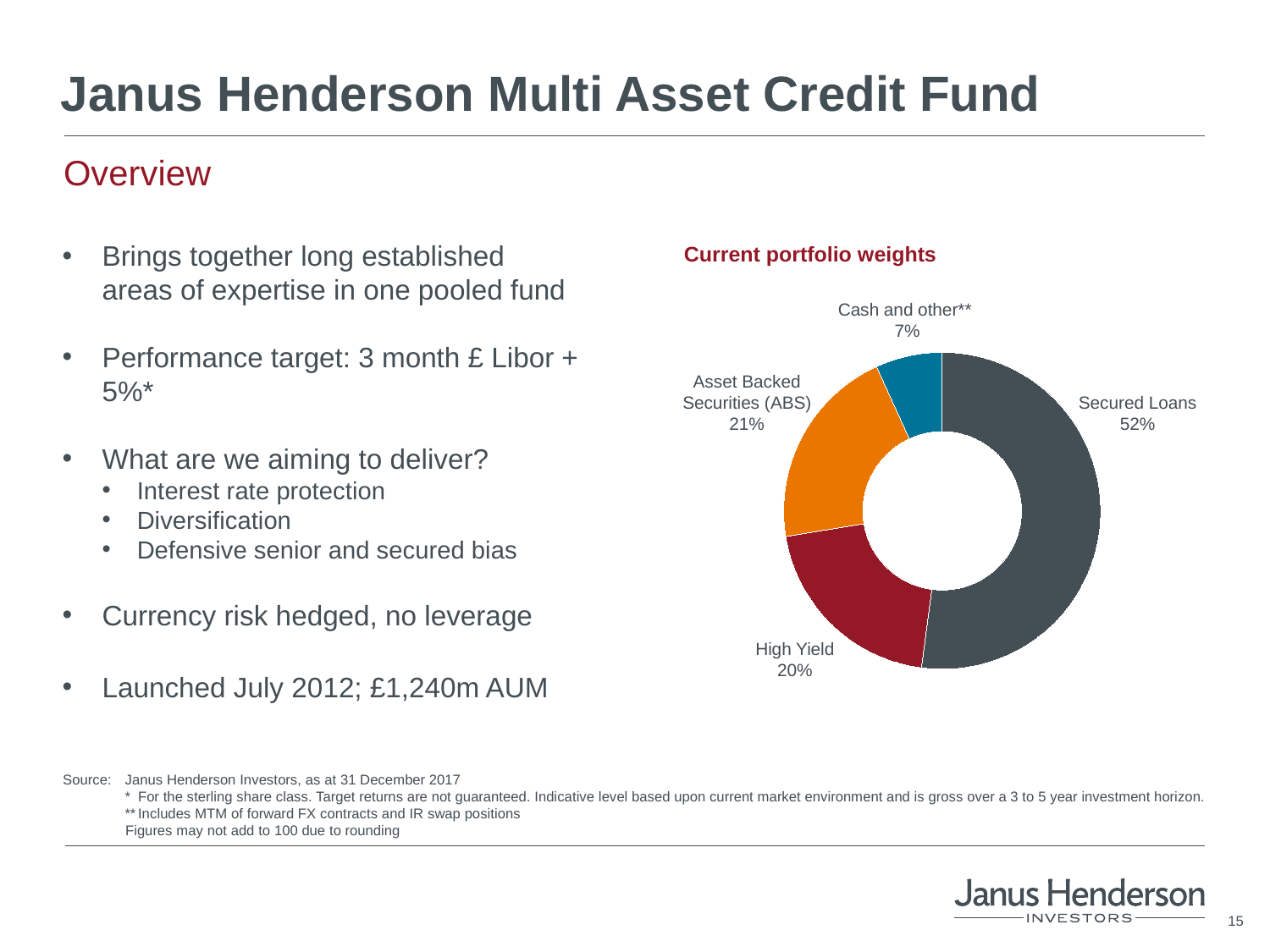
Which has a larger portfolio weight, Asset Backed Securities (ABS) or Cash and other? Asset Backed Securities (ABS) What colour is the Secured Loans segment of the chart? Dark grey How many categories are shown in the portfolio weights chart? 4 What is the portfolio weight of Secured Loans? 52% What is the portfolio weight of Cash and other? 7% What is the difference in portfolio weight between Secured Loans and High Yield? 32 percentage points Which category has the smallest portfolio weight? Cash and other What is the portfolio weight of High Yield? 20% What is the portfolio weight of Asset Backed Securities (ABS)? 21% What is the title of the chart? Current portfolio weights Which category has the largest portfolio weight? Secured Loans What kind of chart is used to show the current portfolio weights? Doughnut (pie) chart